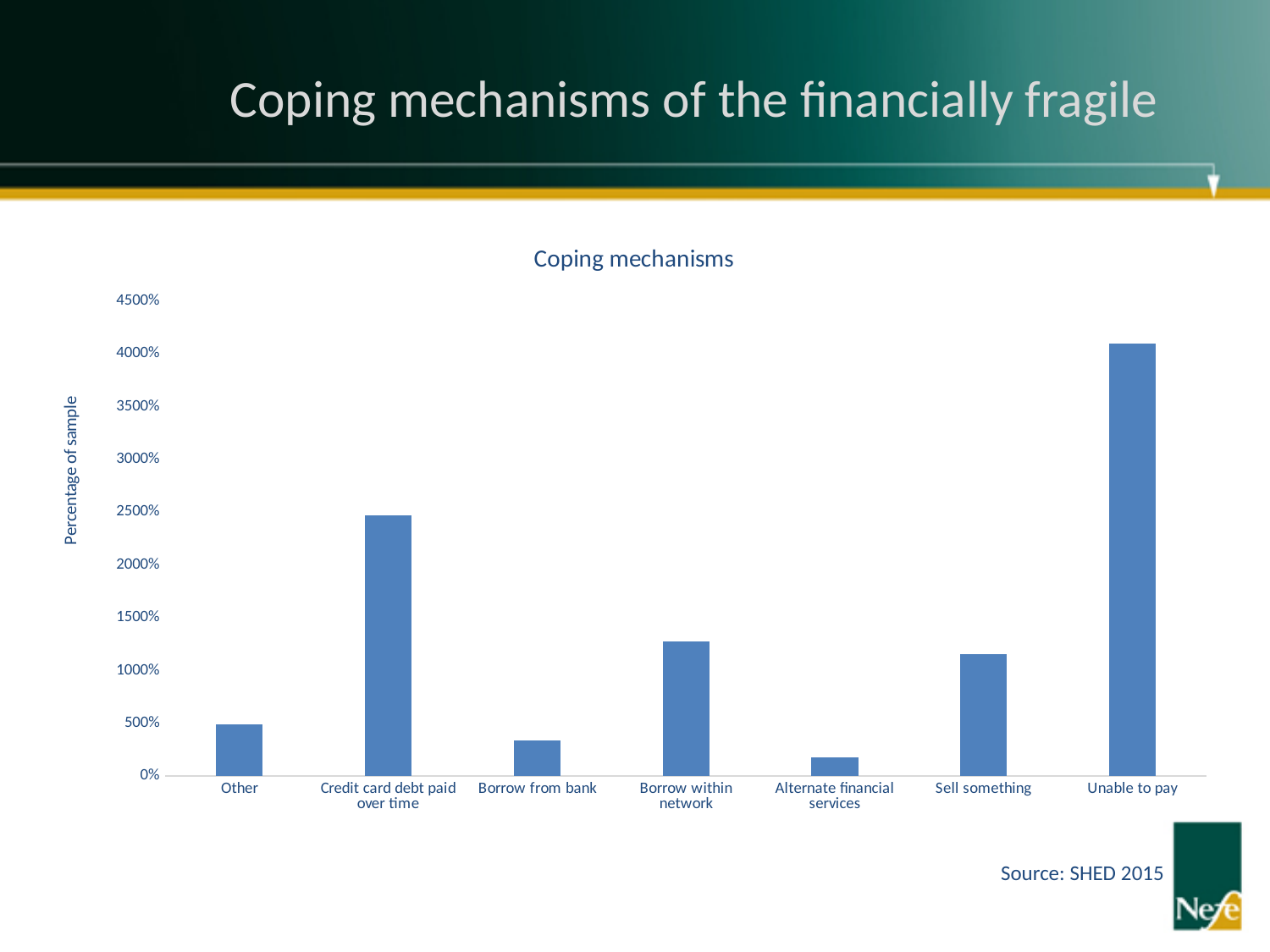
Which category has the lowest value in the chart? Alternate financial services What kind of chart is shown on the slide? Bar chart What is the label on the vertical axis of the chart? Percentage of sample How many categories are shown on the x axis of the chart? 7 Is the value for Alternate financial services greater or less than 500%? less Which is larger, the value for Other or the value for Borrow from bank? Other Is the value for Unable to pay greater or less than 3500%? greater Which is larger, the value for Credit card debt paid over time or the value for Borrow within network? Credit card debt paid over time Is the value for Credit card debt paid over time greater or less than 2000%? greater Which category has the highest value in the chart? Unable to pay